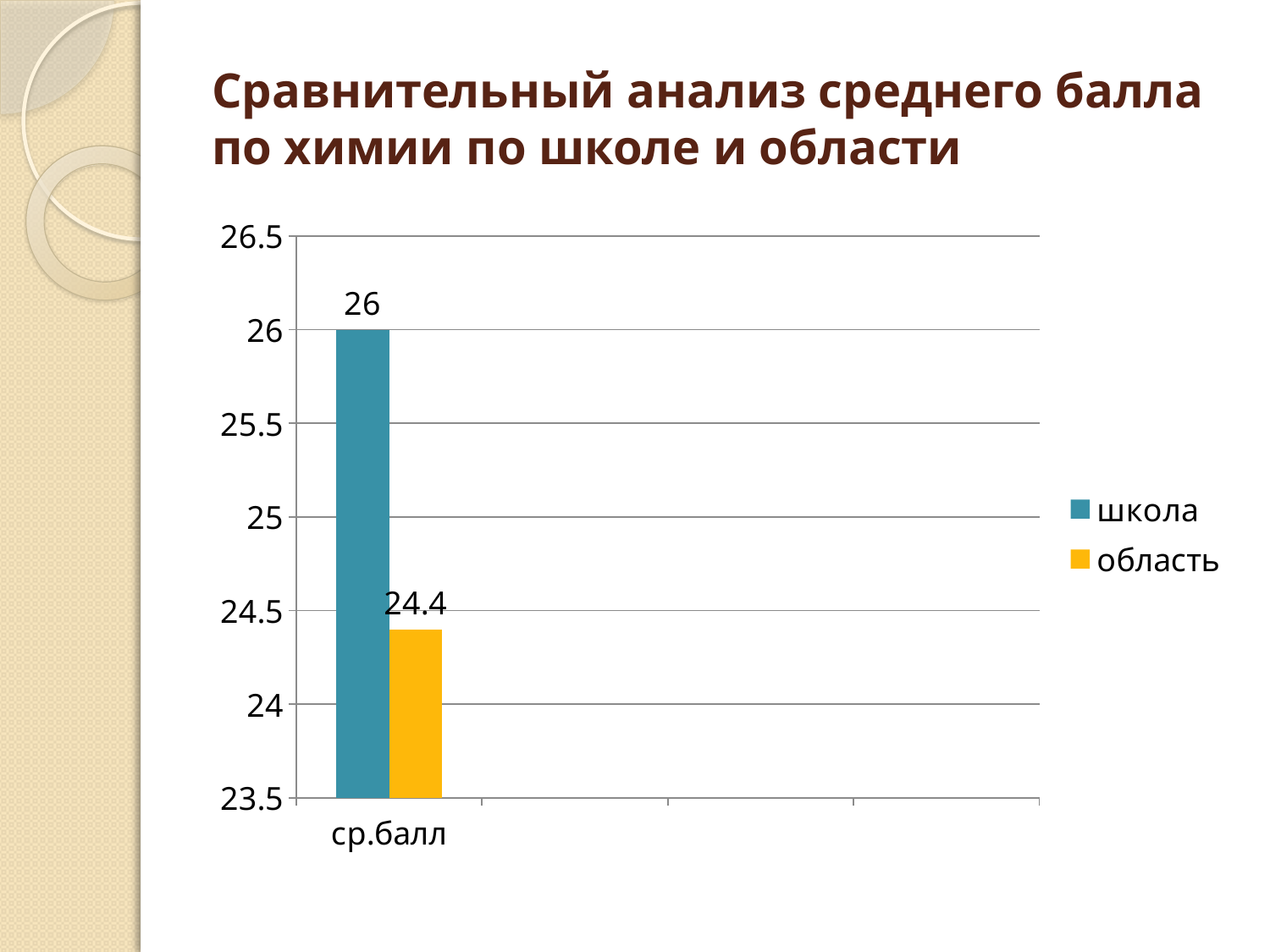
Which colour represents the область series in the legend? yellow Is the value for школа greater or less than 25.5? greater How many series does the legend list? 2 How many categories are shown on the x axis? 1 Which series has the higher value: школа or область? школа Which series has the lowest value on the chart? область What is the value for область in the ср.балл category? 24.4 What is the difference between the школа value and the область value? 1.6 What kind of chart is shown on the slide? bar chart What is the label of the category on the x axis? ср.балл What is the value for школа in the ср.балл category? 26 Is the value for область greater or less than 25? less